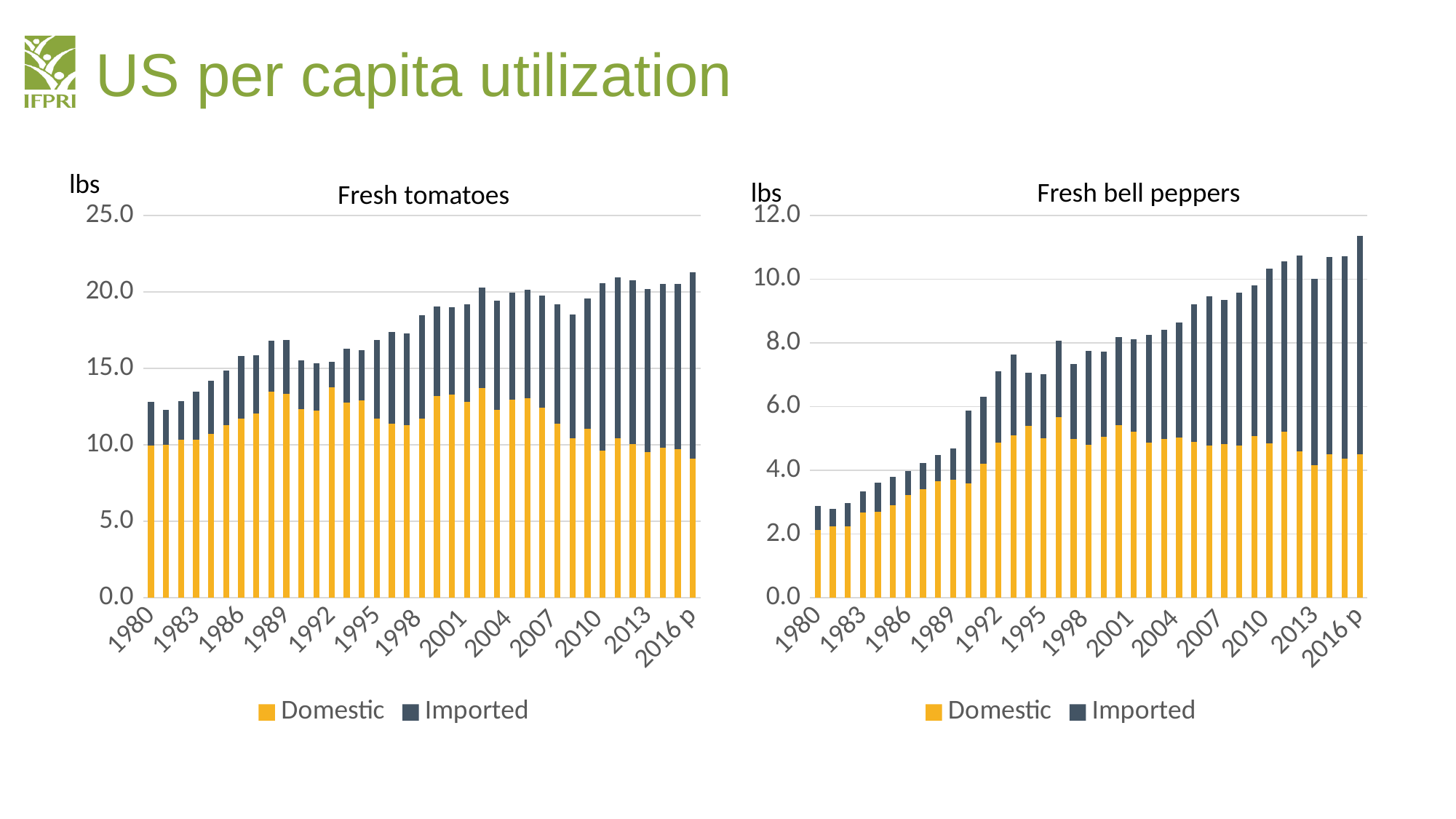
In the Fresh tomatoes chart, is the total value for 1980 greater or less than 15.0? less What kind of chart is the Fresh tomatoes chart? Stacked bar chart How many series does the legend of the Fresh bell peppers chart list? 2 In the Fresh tomatoes chart, is the Domestic value for 2016 p greater or less than 10.0? less What unit is shown on the y axis of both charts? lbs In the Fresh tomatoes chart, which total is larger, 1980 or 2016 p? 2016 p In the Fresh tomatoes chart, is the total value for 2016 p greater or less than 20.0? greater What are the two series shown in the Fresh tomatoes chart? Domestic and Imported In the Fresh bell peppers chart, which year has the highest total bar? 2016 p In the Fresh bell peppers chart, do the total values generally rise or fall from 1980 to 2016 p? Rise